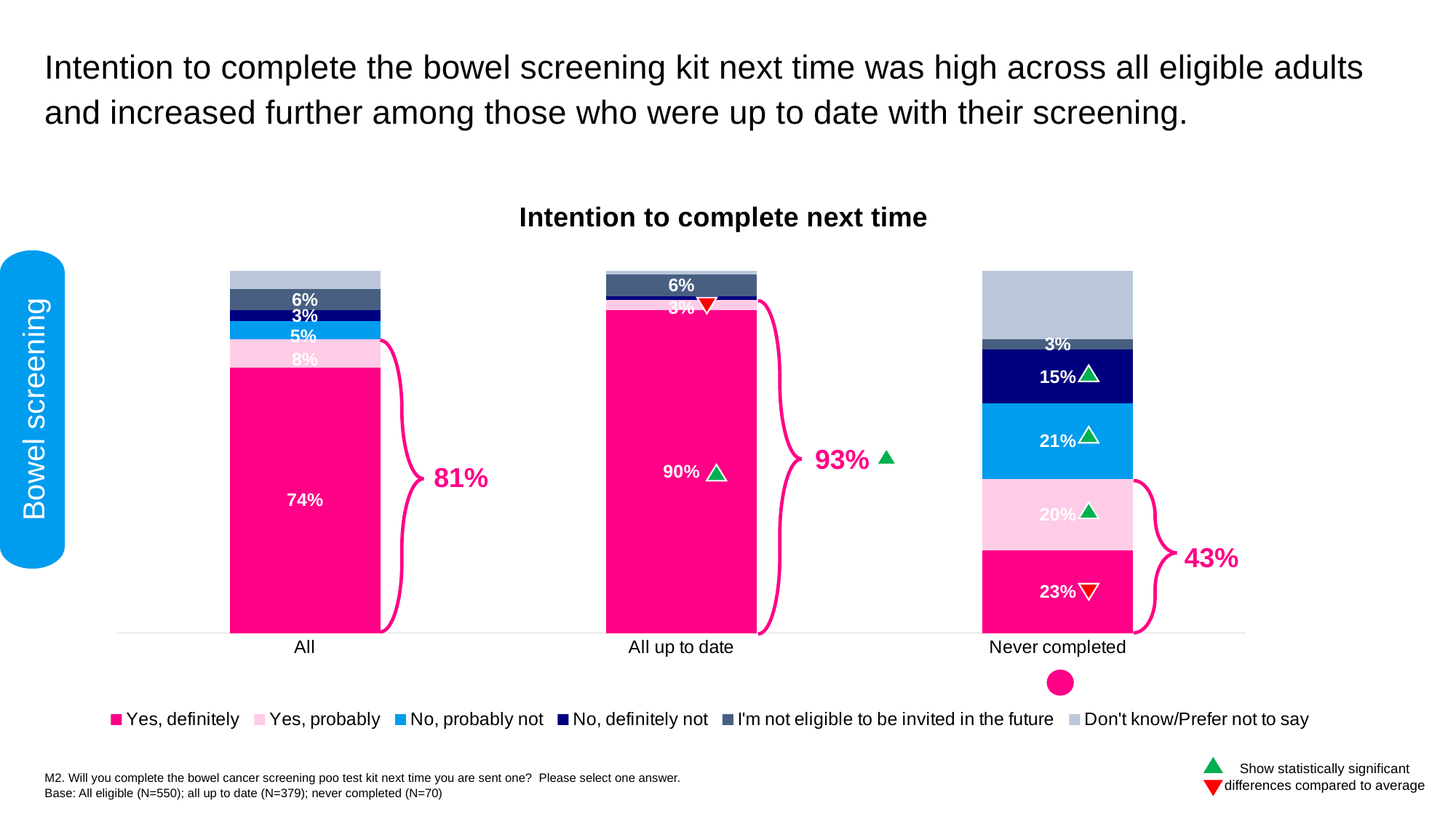
What is the difference between the 'Yes, definitely' values for 'All up to date' and 'All'? 16% What is the value for 'Yes, definitely' in the 'Never completed' bar? 23% How many groups (bars) are shown on the x axis? 3 What is the value for 'Yes, definitely' in the 'All up to date' bar? 90% How many series does the legend list? 6 What is the value for 'No, probably not' in the 'Never completed' bar? 21% What is the value for 'Yes, definitely' in the 'All' bar? 74% Which is larger in the 'Never completed' bar: 'Yes, probably' or 'No, definitely not'? Yes, probably What is the value for 'No, definitely not' in the 'Never completed' bar? 15% What kind of chart is shown on the slide? Stacked bar chart Which group has the lowest 'Yes, definitely' value? Never completed Which group has the highest 'Yes, definitely' value? All up to date